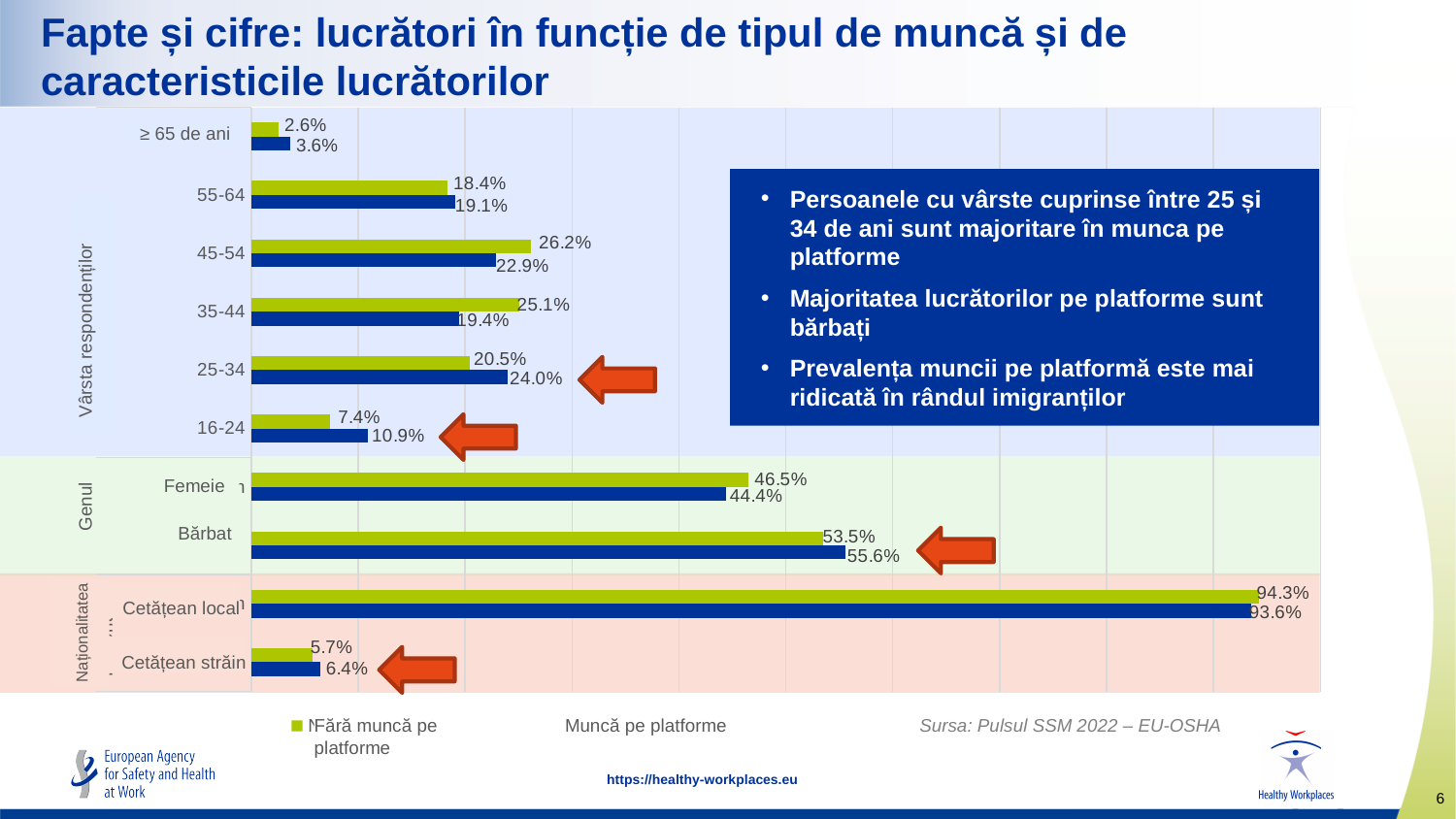
What is the value for "Muncă pe platforme" in the 25-34 age group? 24.0% What is the source cited for the chart? Pulsul SSM 2022 – EU-OSHA For the 16-24 age group, which series has the larger value: "Fără muncă pe platforme" or "Muncă pe platforme"? Muncă pe platforme What is the value for "Muncă pe platforme" for Cetățean străin? 6.4% Among the age groups, which has the lowest value for "Fără muncă pe platforme"? ≥ 65 de ani What is the value for "Fără muncă pe platforme" in the 45-54 age group? 26.2% For Femeie, which series has the larger value: "Fără muncă pe platforme" or "Muncă pe platforme"? Fără muncă pe platforme What is the difference between the "Muncă pe platforme" and "Fără muncă pe platforme" values for Bărbat? 2.1% How many categories are plotted on the chart? 10 What kind of chart is shown on the slide? Bar chart How many series does the legend list? 2 Among the age groups, which has the highest value for "Muncă pe platforme"? 25-34